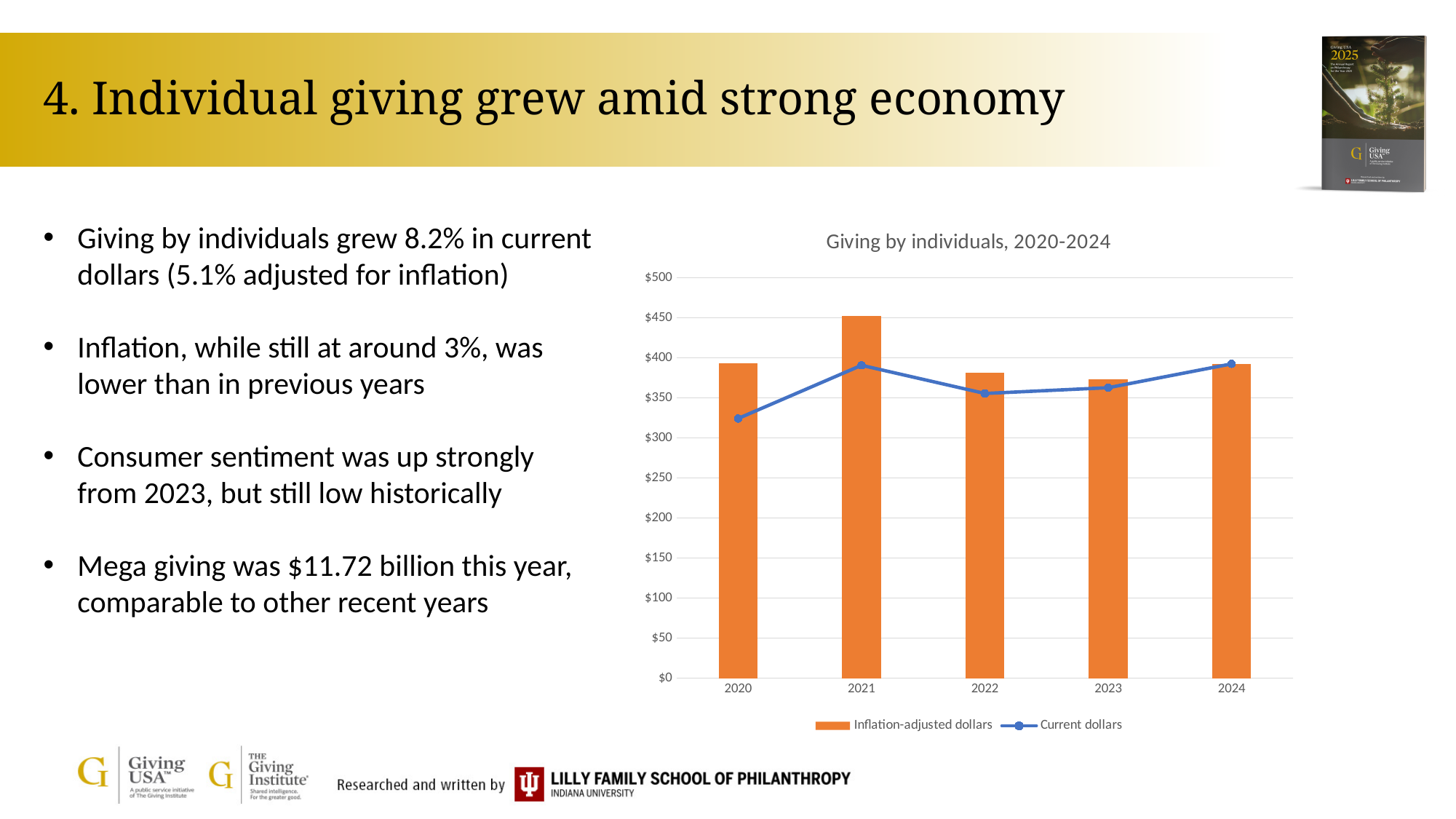
Does the current dollars line rise or fall from 2022 to 2024? Rises How many years are shown on the x axis of the chart? 5 How many series does the chart legend list? 2 What is the title of the chart? Giving by individuals, 2020-2024 What kind of chart is shown on the slide? A combined bar and line chart Which year has the lowest value on the current dollars line? 2020 Is the inflation-adjusted dollars value for 2021 greater or less than $400? greater What are the two series named in the legend? Inflation-adjusted dollars and Current dollars Which year has the highest inflation-adjusted dollars bar? 2021 Is the current dollars value for 2020 greater or less than $350? less Which is larger in 2020, the inflation-adjusted dollars bar or the current dollars point? Inflation-adjusted dollars Is the inflation-adjusted dollars value for 2022 greater or less than $350? greater